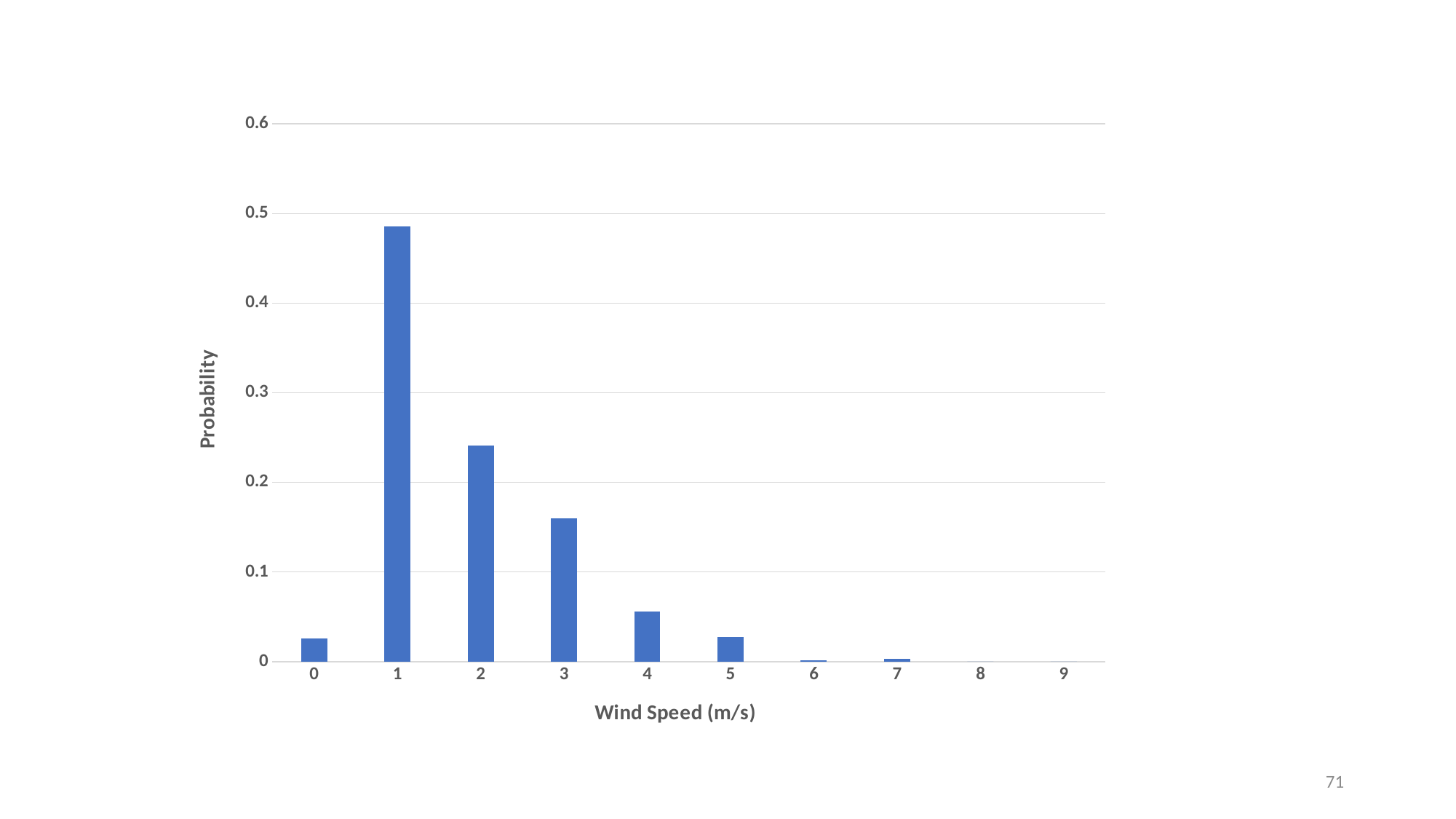
Is the probability for wind speed 4 greater or less than 0.1? less Is the probability for wind speed 2 greater or less than 0.2? greater Do the probabilities rise or fall as wind speed increases from 1 to 5 m/s? fall Which has a higher probability, wind speed 4 or wind speed 5? 4 Which has a higher probability, wind speed 2 or wind speed 3? 2 How many wind speed categories are shown on the x axis? 10 Is the probability for wind speed 1 greater or less than 0.5? less What kind of chart is shown on the slide? bar chart What is the label of the x axis? Wind Speed (m/s) Which wind speed has the highest probability? 1